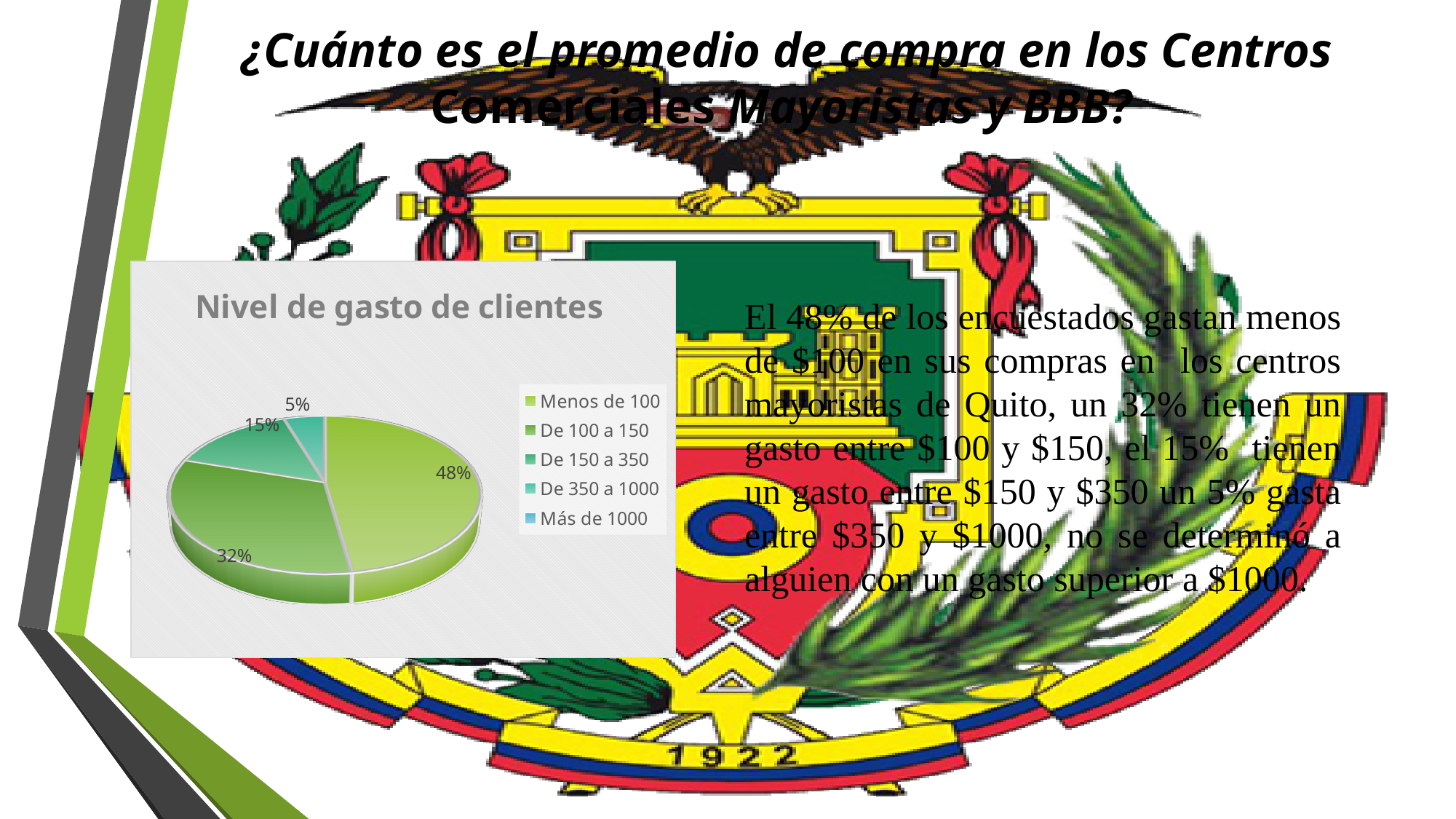
How many entries does the chart legend list? 5 What is the title of the chart? Nivel de gasto de clientes Which labelled slice is the smallest in the pie? De 350 a 1000 What share of the pie does the 'De 350 a 1000' slice represent? 5% What share of the pie does the 'Menos de 100' slice represent? 48% What type of chart is shown on the slide? Pie chart What share of the pie does the 'De 100 a 150' slice represent? 32% Which slice is larger, 'De 150 a 350' or 'De 350 a 1000'? De 150 a 350 What is the combined share of the 'Menos de 100' and 'De 100 a 150' slices? 80% What is the difference in percentage points between the 'Menos de 100' and 'De 100 a 150' slices? 16 Which category has the largest slice of the pie? Menos de 100